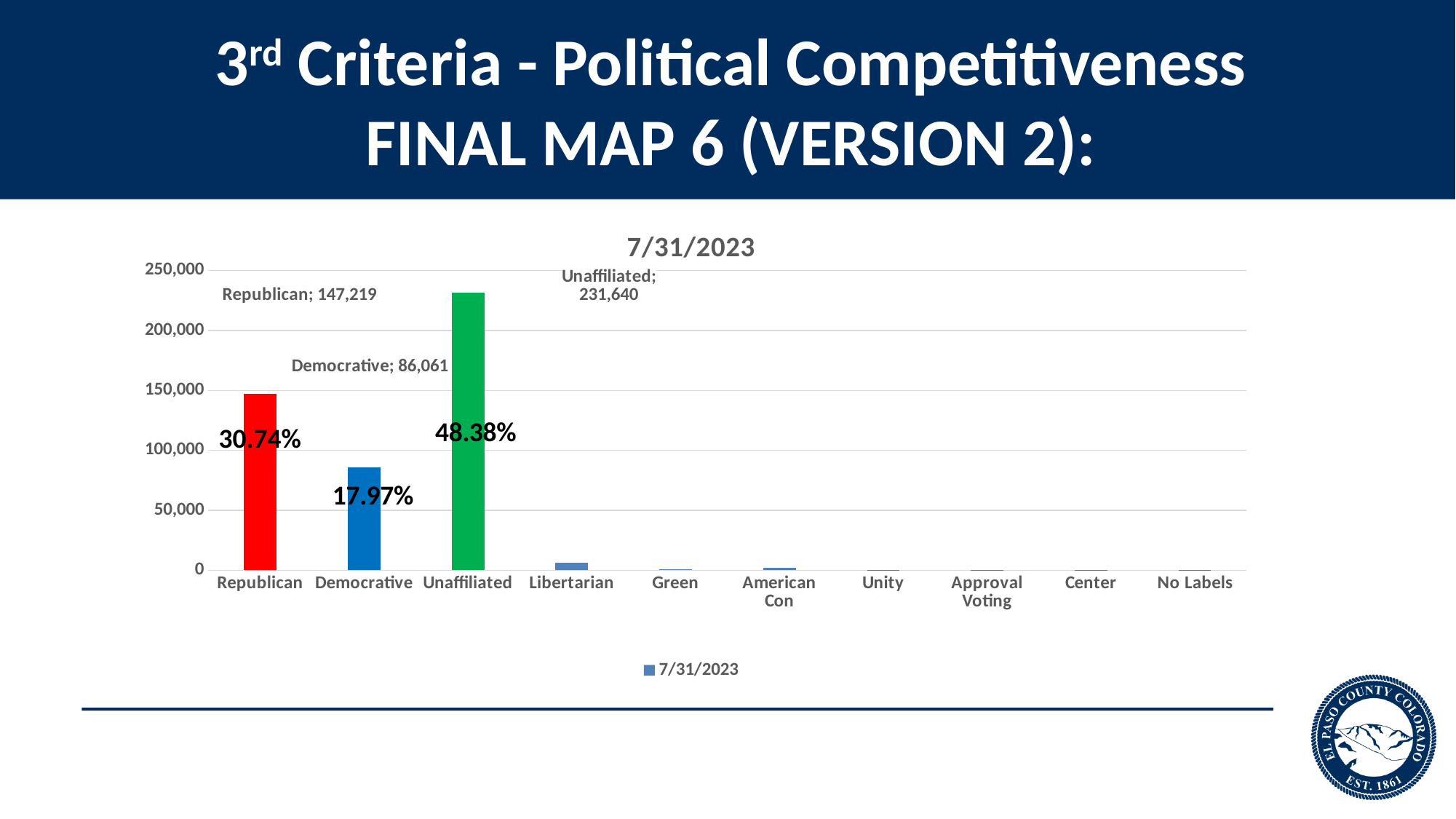
What is the difference between the Unaffiliated and Republican values? 84,421 What is the value for Unaffiliated? 231,640 What is the value for Democrative? 86,061 What kind of chart is shown on the slide? bar chart What is the difference between the Republican and Democrative values? 61,158 What is the title of the chart? 7/31/2023 Which category has the highest value? Unaffiliated What percentage is shown for the Unaffiliated bar? 48.38% Which is larger, the value for Republican or the value for Democrative? Republican What is the value for Republican? 147,219 Is the value for Libertarian greater or less than 50,000? less How many categories are shown on the x axis? 10